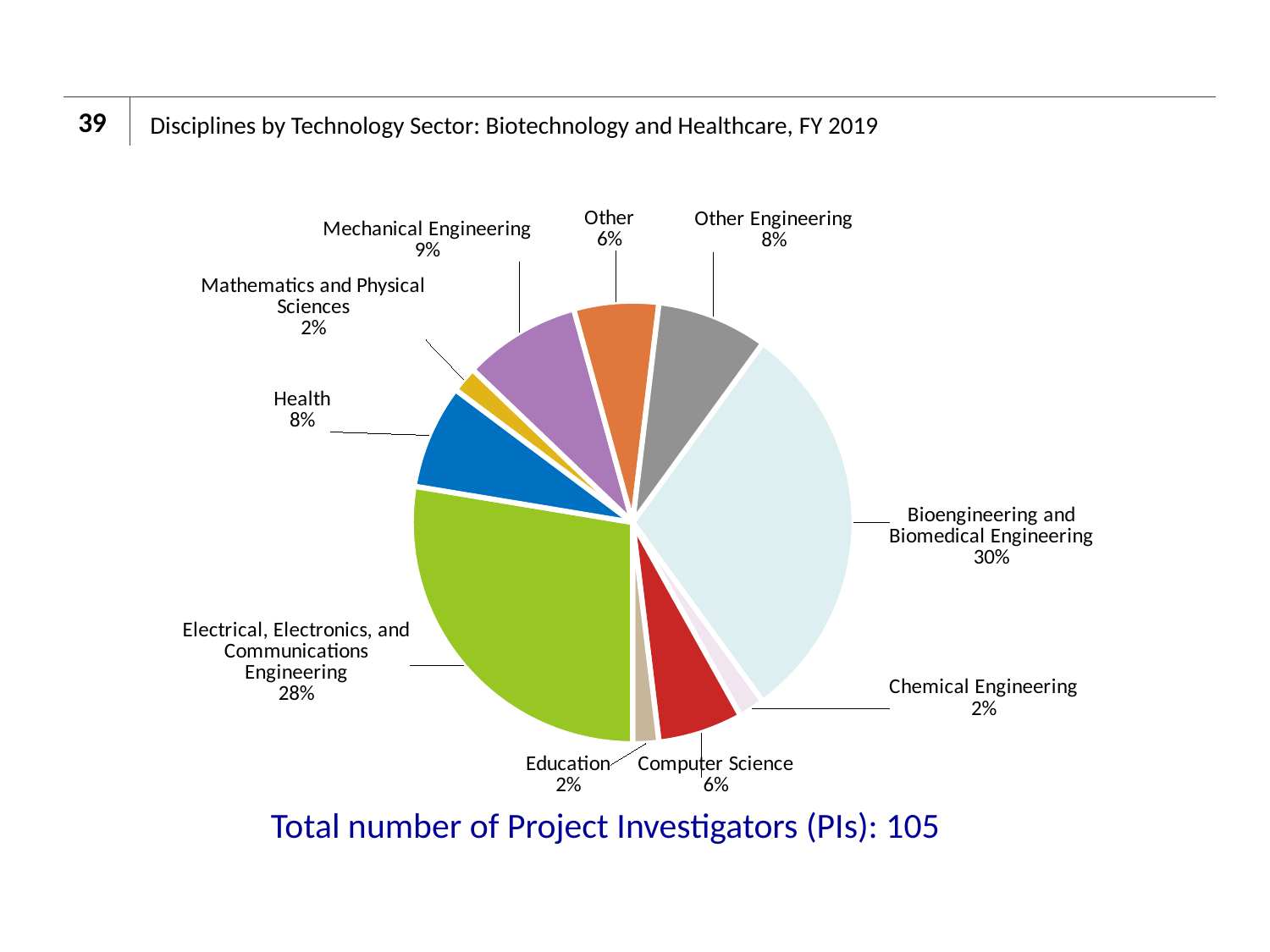
What is the title of the chart on the slide? Disciplines by Technology Sector: Biotechnology and Healthcare, FY 2019 What percentage is shown for Health? 8% What percentage is shown for Mechanical Engineering? 9% Which is larger, the slice for Computer Science or the slice for Other Engineering? Other Engineering What percentage is shown for Electrical, Electronics, and Communications Engineering? 28% What kind of chart is shown on the slide? Pie chart What share of the pie does Bioengineering and Biomedical Engineering hold? 30% What is the total number of Project Investigators (PIs) stated below the chart? 105 What is the difference in percentage points between Bioengineering and Biomedical Engineering and Electrical, Electronics, and Communications Engineering? 2 percentage points How many disciplines (slices) are shown in the pie chart? 10 What percentage is shown for Chemical Engineering? 2% Which discipline has the largest slice of the pie? Bioengineering and Biomedical Engineering